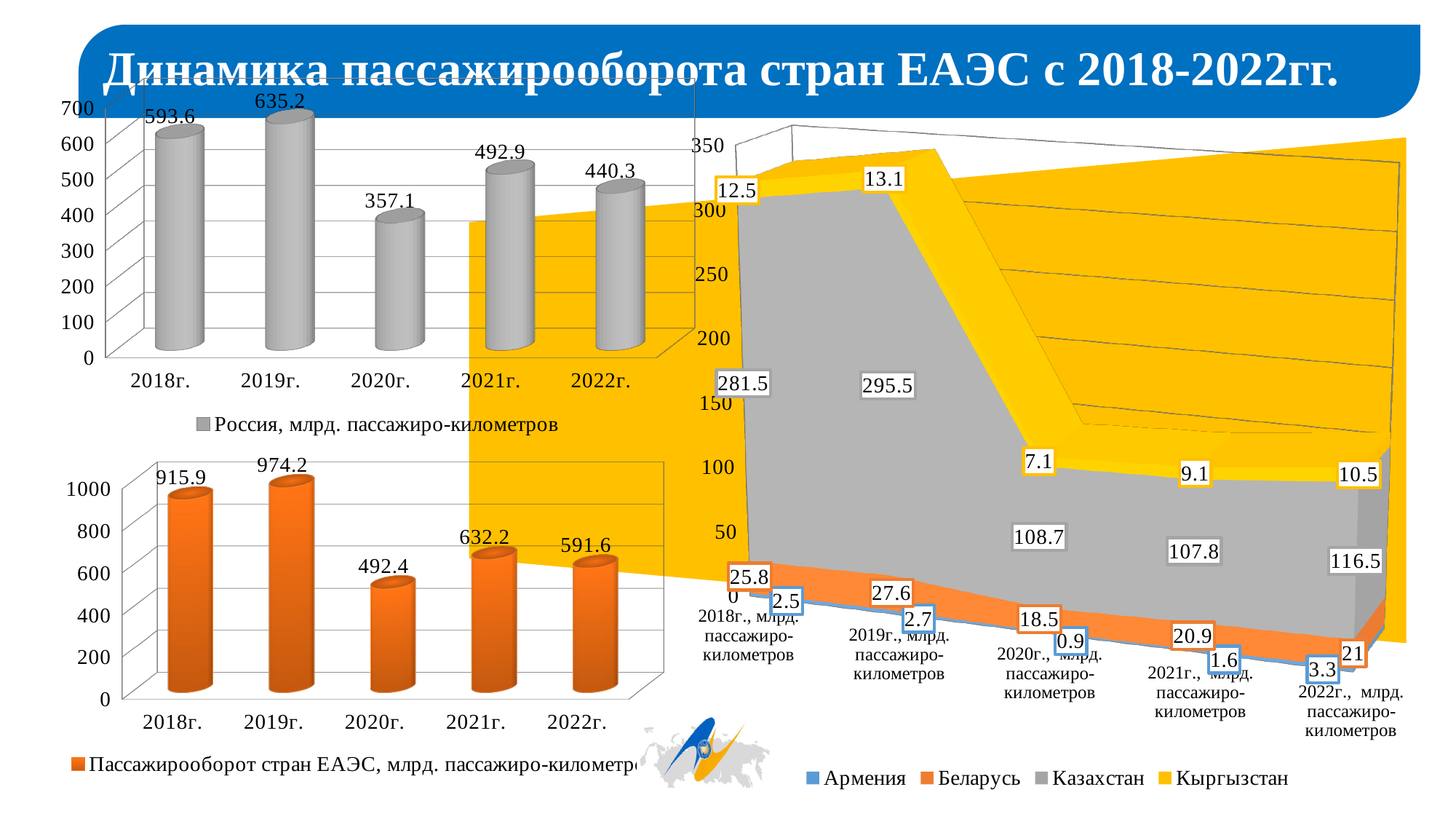
In the right chart, which is larger in 2018г.: Беларусь or Кыргызстан? Беларусь In the top-left chart (Россия), which year has the highest value? 2019г. In the right chart, what is the difference between the Казахстан values for 2022г. and 2021г.? 8.7 In the bottom-left chart (Пассажирооборот стран ЕАЭС), which year has the lowest value? 2020г. In the right chart, what is the value for Армения in 2020г.? 0.9 In the top-left chart (Россия), what is the value for 2020г.? 357.1 In the right chart, what is the value for Казахстан in 2019г.? 295.5 In the top-left chart (Россия), how many years are shown on the x axis? 5 What kind of chart is the bottom-left chart (Пассажирооборот стран ЕАЭС)? bar chart In the right chart, how many series does the legend list? 4 In the bottom-left chart (Пассажирооборот стран ЕАЭС), what is the value for 2021г.? 632.2 In the top-left chart (Россия), what is the difference between the 2019г. and 2018г. values? 41.6